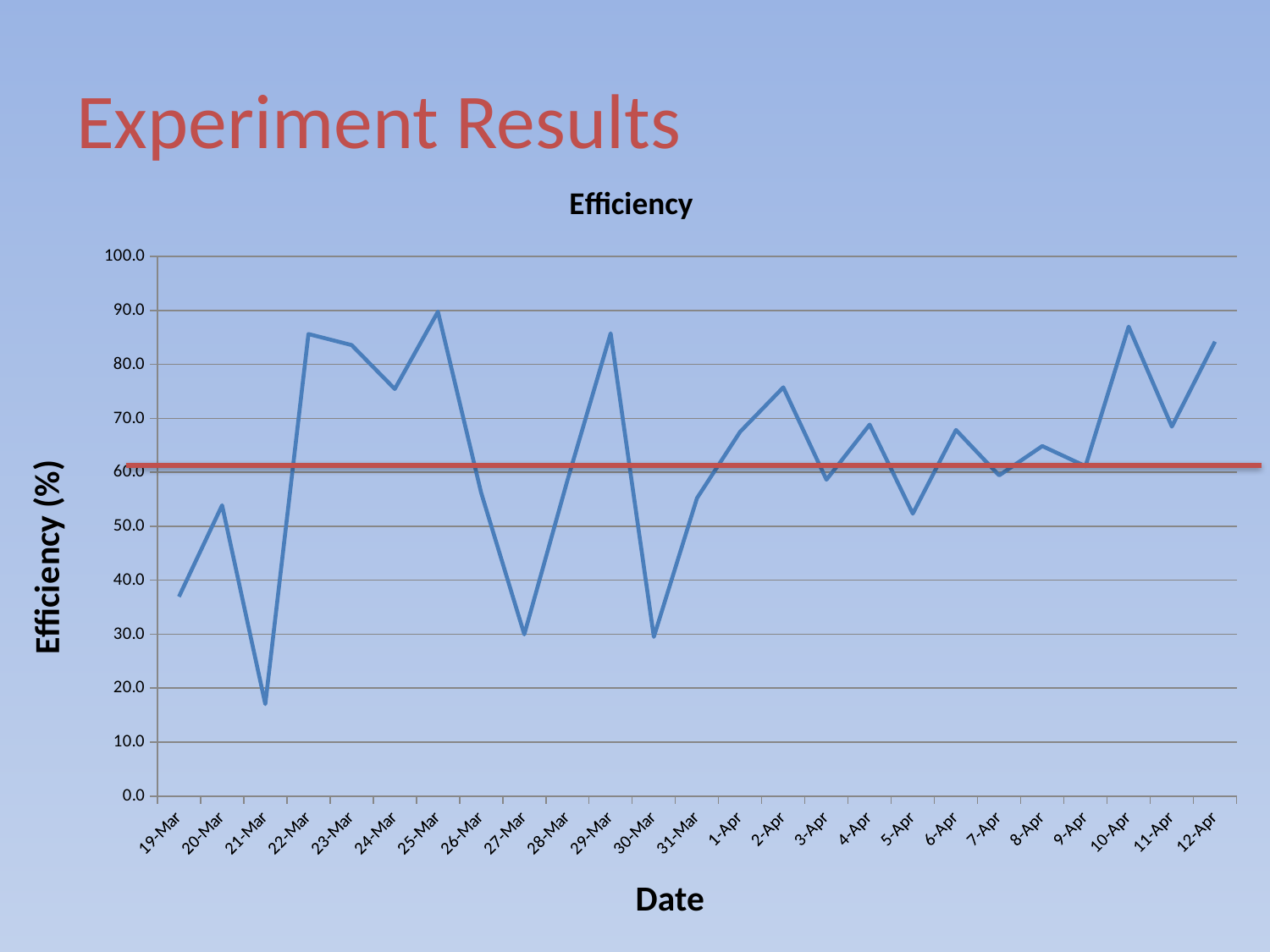
How many dates are plotted along the x axis of the chart? 25 Is the value for 25-Mar greater or less than 80.0? greater What kind of chart is shown on the slide? line chart What is the label on the vertical axis of the chart? Efficiency (%) Which date has the higher efficiency, 27-Mar or 29-Mar? 29-Mar Is the value for 21-Mar greater or less than 20.0? less Is the value for 2-Apr greater or less than 70.0? greater What is the title of the chart? Efficiency Which date has the higher efficiency, 21-Mar or 22-Mar? 22-Mar On which date is the efficiency lowest? 21-Mar